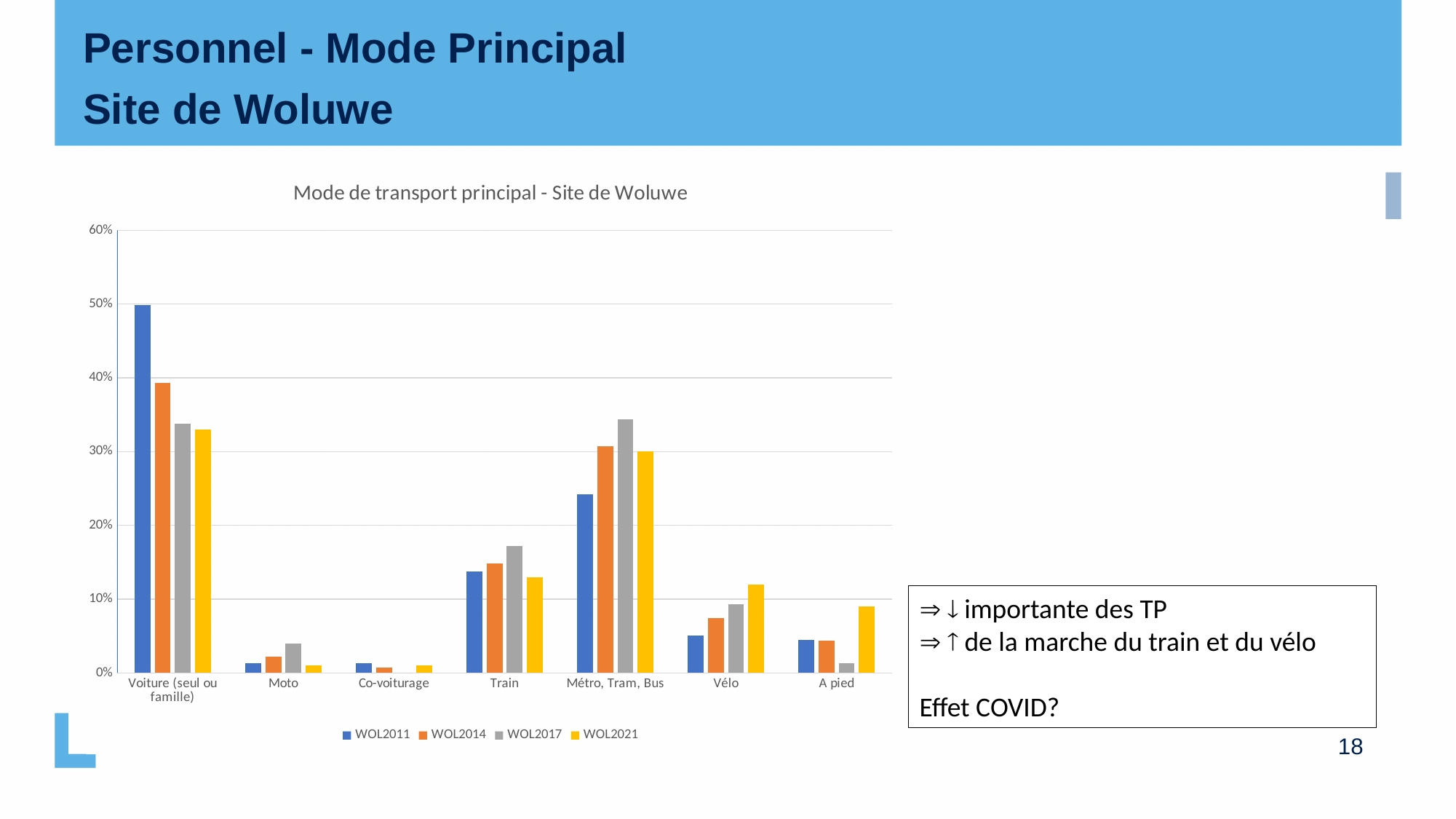
How many transport mode categories are shown on the x axis? 7 What is the title of the chart? Mode de transport principal - Site de Woluwe What kind of chart is shown on the slide? bar chart Do the values for Voiture (seul ou famille) rise or fall from WOL2011 to WOL2021? fall How many series does the legend list? 4 Do the values for Vélo rise or fall from WOL2011 to WOL2021? rise Which category has the highest value for WOL2011? Voiture (seul ou famille) Is the WOL2017 value for Métro, Tram, Bus greater or less than 30%? greater For WOL2014, which is larger: Train or Métro, Tram, Bus? Métro, Tram, Bus Is the WOL2017 value for A pied greater or less than 5%? less Is the WOL2011 value for Voiture (seul ou famille) greater or less than 40%? greater For Vélo, which is larger: the WOL2011 value or the WOL2021 value? WOL2021